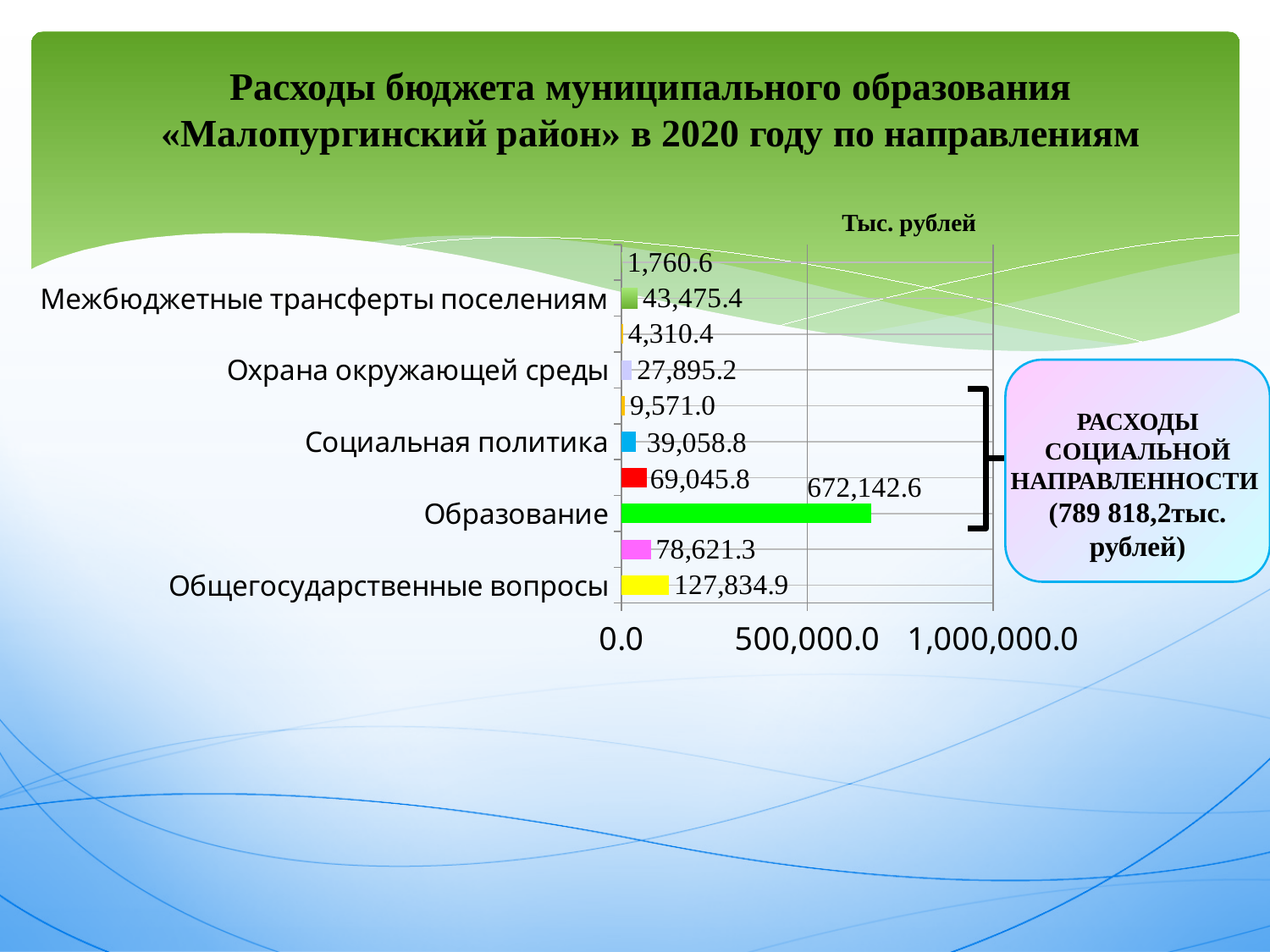
What is the value for Охрана окружающей среды? 27,895.2 What type of chart is shown on the slide? bar chart What is the value for Межбюджетные трансферты поселениям? 43,475.4 What is the value for Социальная политика? 39,058.8 What is the value for Образование? 672,142.6 What is the smallest value labelled on the chart? 1,760.6 How many bars are plotted on the chart? 10 What is the value for Общегосударственные вопросы? 127,834.9 Which is larger, the value for Социальная политика or the value for Охрана окружающей среды? Социальная политика What is the difference between the values for Образование and Общегосударственные вопросы? 544,307.7 Which category has the highest value? Образование Is the value for Образование greater or less than 500,000.0? greater